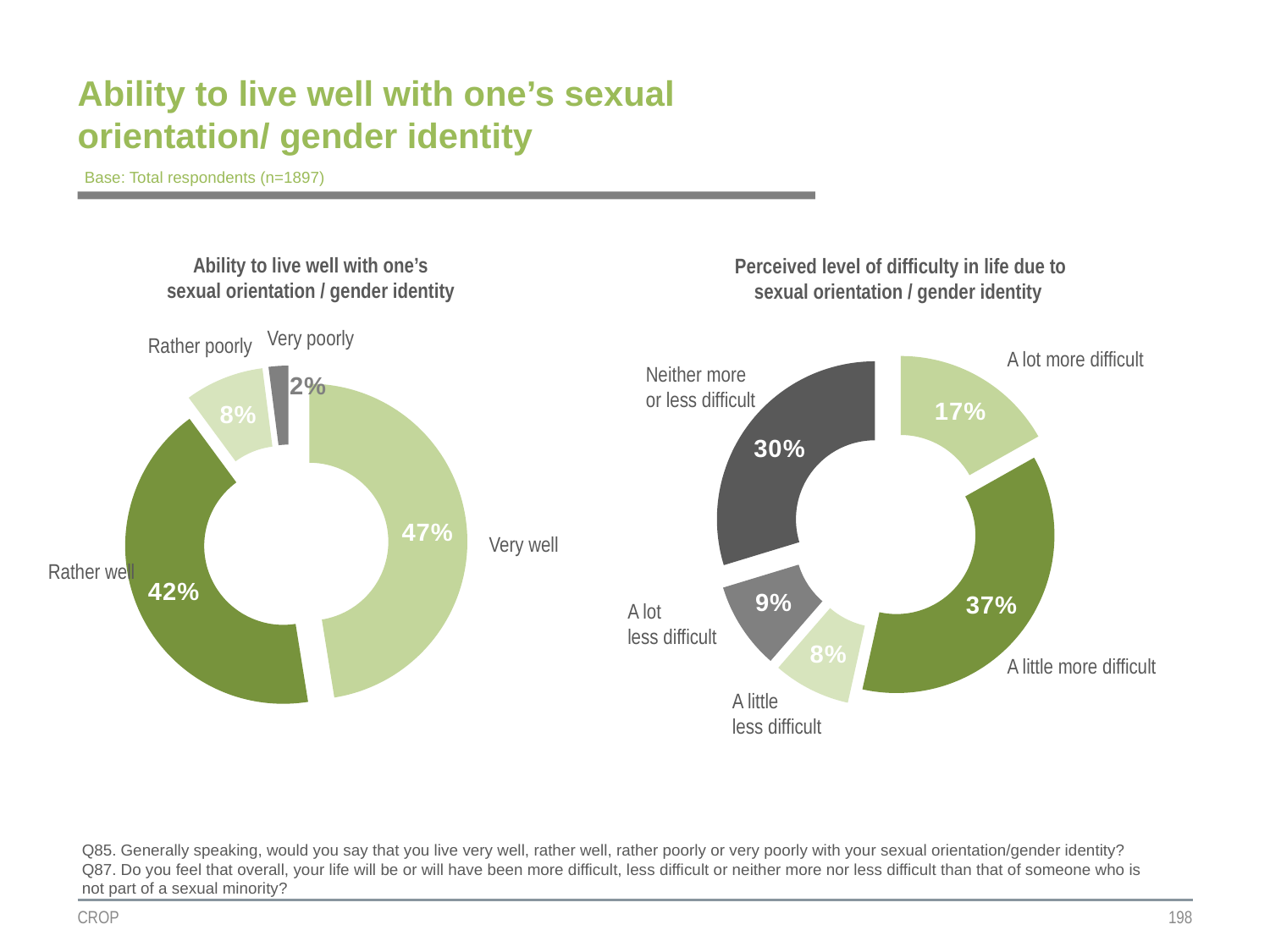
In the right chart (Perceived level of difficulty in life due to sexual orientation / gender identity), what is the difference between 'A little more difficult' and 'A lot more difficult'? 20% In the right chart (Perceived level of difficulty in life due to sexual orientation / gender identity), which is larger: 'A lot more difficult' or 'A lot less difficult'? A lot more difficult In the right chart (Perceived level of difficulty in life due to sexual orientation / gender identity), what is the value for 'Neither more or less difficult'? 30% In the left chart (Ability to live well with one's sexual orientation / gender identity), which category has the smallest share? Very poorly In the right chart (Perceived level of difficulty in life due to sexual orientation / gender identity), which category has the largest share? A little more difficult In the right chart (Perceived level of difficulty in life due to sexual orientation / gender identity), how many categories are shown? 5 In the left chart (Ability to live well with one's sexual orientation / gender identity), what is the difference between 'Very well' and 'Rather well'? 5% In the right chart (Perceived level of difficulty in life due to sexual orientation / gender identity), what percentage said 'A little more difficult'? 37% In the left chart (Ability to live well with one's sexual orientation / gender identity), what percentage of respondents said they live very well? 47% What type of chart is used on this slide? Doughnut chart In the left chart (Ability to live well with one's sexual orientation / gender identity), how many categories are shown? 4 In the left chart (Ability to live well with one's sexual orientation / gender identity), what is the value for 'Rather poorly'? 8%